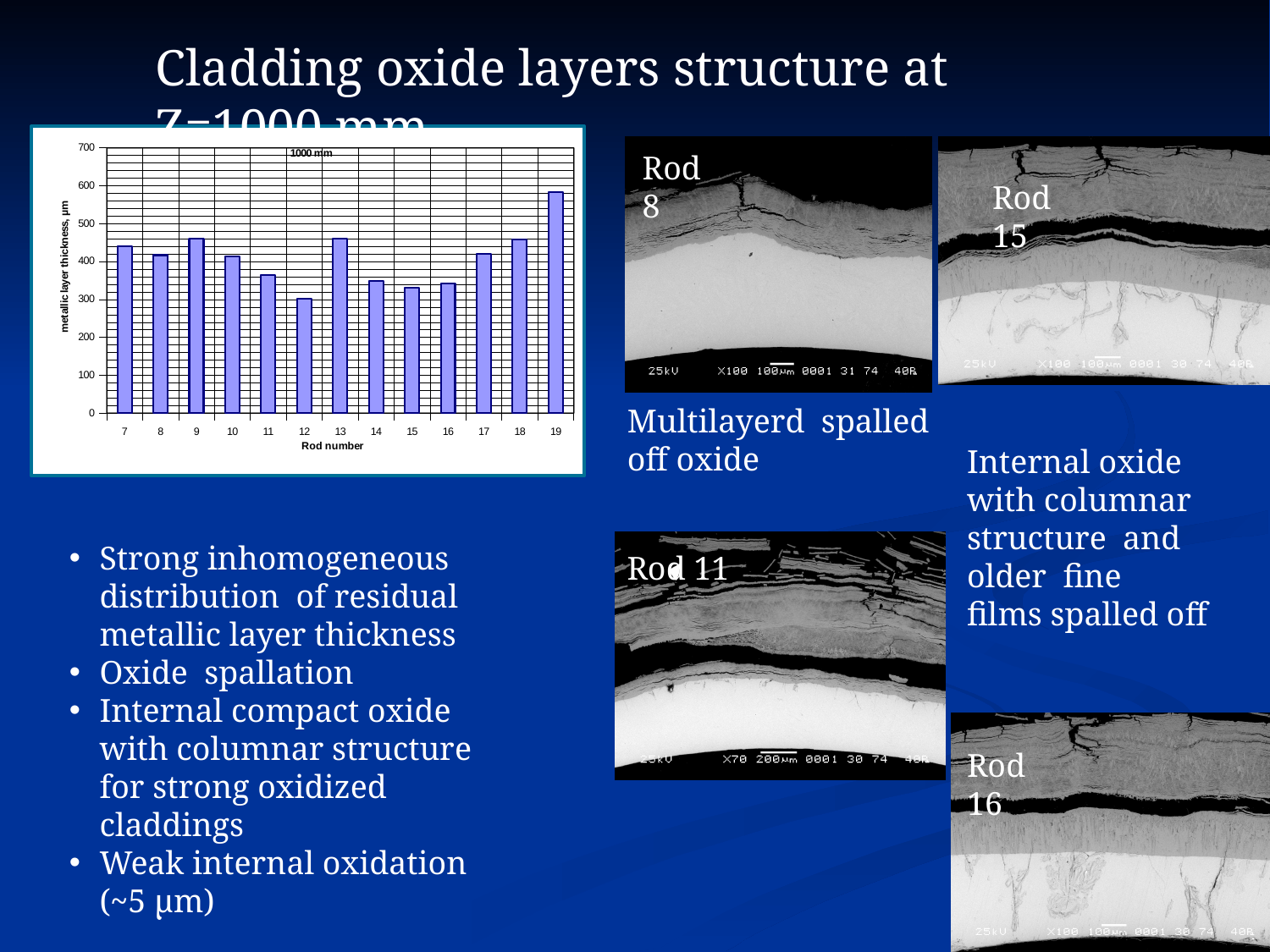
What kind of chart is shown on the slide? bar chart Is the metallic layer thickness for rod 7 greater or less than 400? greater What is the label of the y axis of the chart? metallic layer thickness, µm Which rod number has the lowest metallic layer thickness in the chart? 12 How many rod numbers are plotted on the x axis of the chart? 13 Which rod number has the highest metallic layer thickness in the chart? 19 Is the metallic layer thickness for rod 15 greater or less than 400? less Which has a larger metallic layer thickness, rod 9 or rod 15? rod 9 What is the label of the x axis of the chart? Rod number Which has a larger metallic layer thickness, rod 11 or rod 19? rod 19 Is the metallic layer thickness for rod 12 greater or less than 400? less